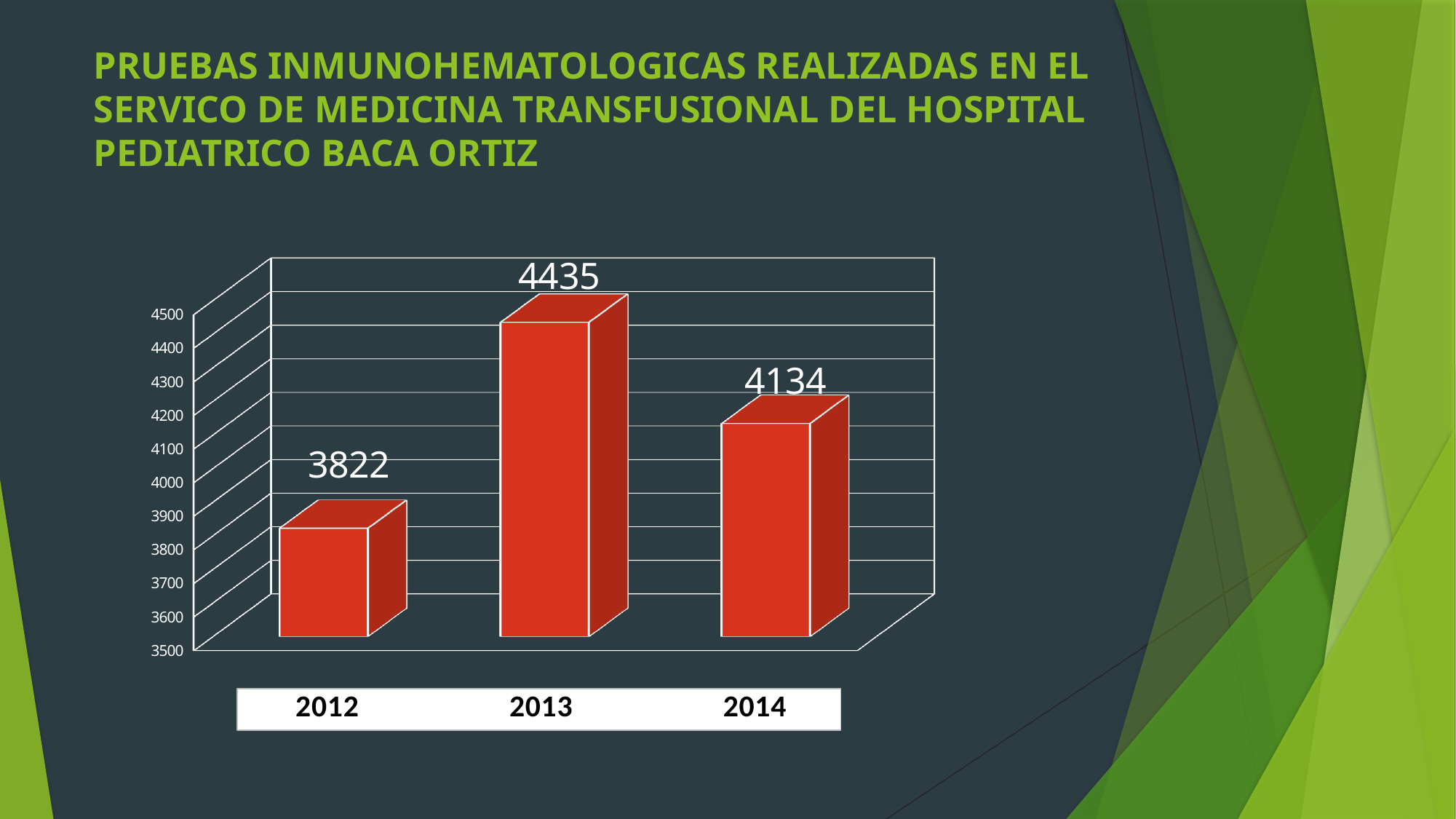
What is the value for 2012? 3822 Is the value for 2012 greater or less than 4000? less What colour are the bars in the chart? red What is the difference between the values for 2013 and 2014? 301 How many years are shown on the x axis? 3 Which is larger, the value for 2014 or the value for 2012? 2014 What is the difference between the values for 2013 and 2012? 613 What is the value for 2013? 4435 What is the value for 2014? 4134 Which year has the highest value? 2013 What kind of chart is shown on the slide? bar chart Which year has the lowest value? 2012